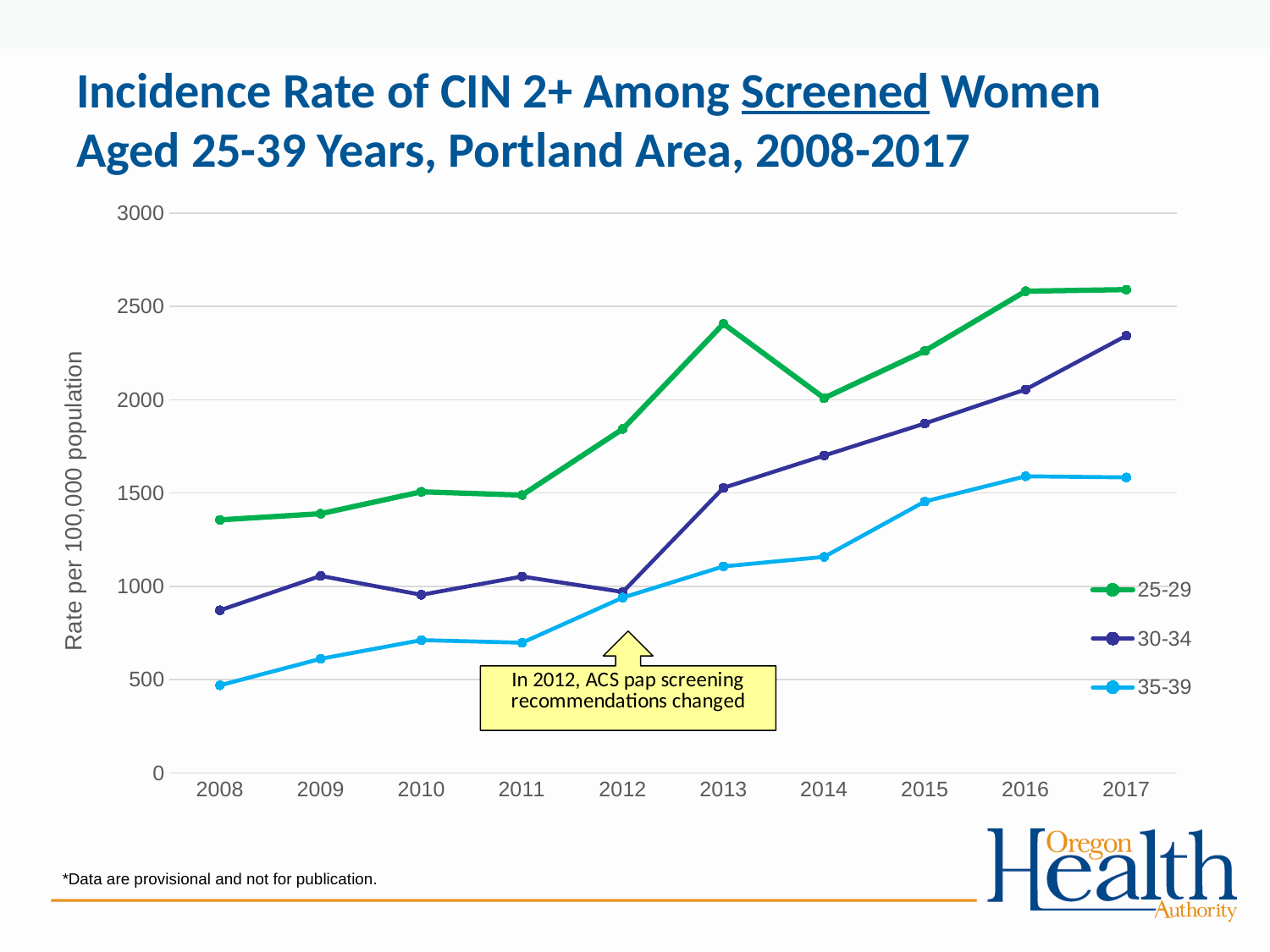
How many series does the legend list? 3 Which age group has the lowest incidence rate in 2008? 35-39 What is the label on the y axis of the chart? Rate per 100,000 population Is the value for the 25-29 age group in 2008 greater or less than 1500? less How many years are plotted along the x axis? 10 Is the value for the 35-39 age group in 2008 greater or less than 500? less Which age group has the highest incidence rate in 2017? 25-29 Is the value for the 25-29 age group in 2013 greater or less than 2000? greater Does the incidence rate for the 35-39 age group generally rise or fall from 2008 to 2017? rise What kind of chart is shown on the slide? line chart For the 25-29 age group, which year has the larger value, 2013 or 2014? 2013